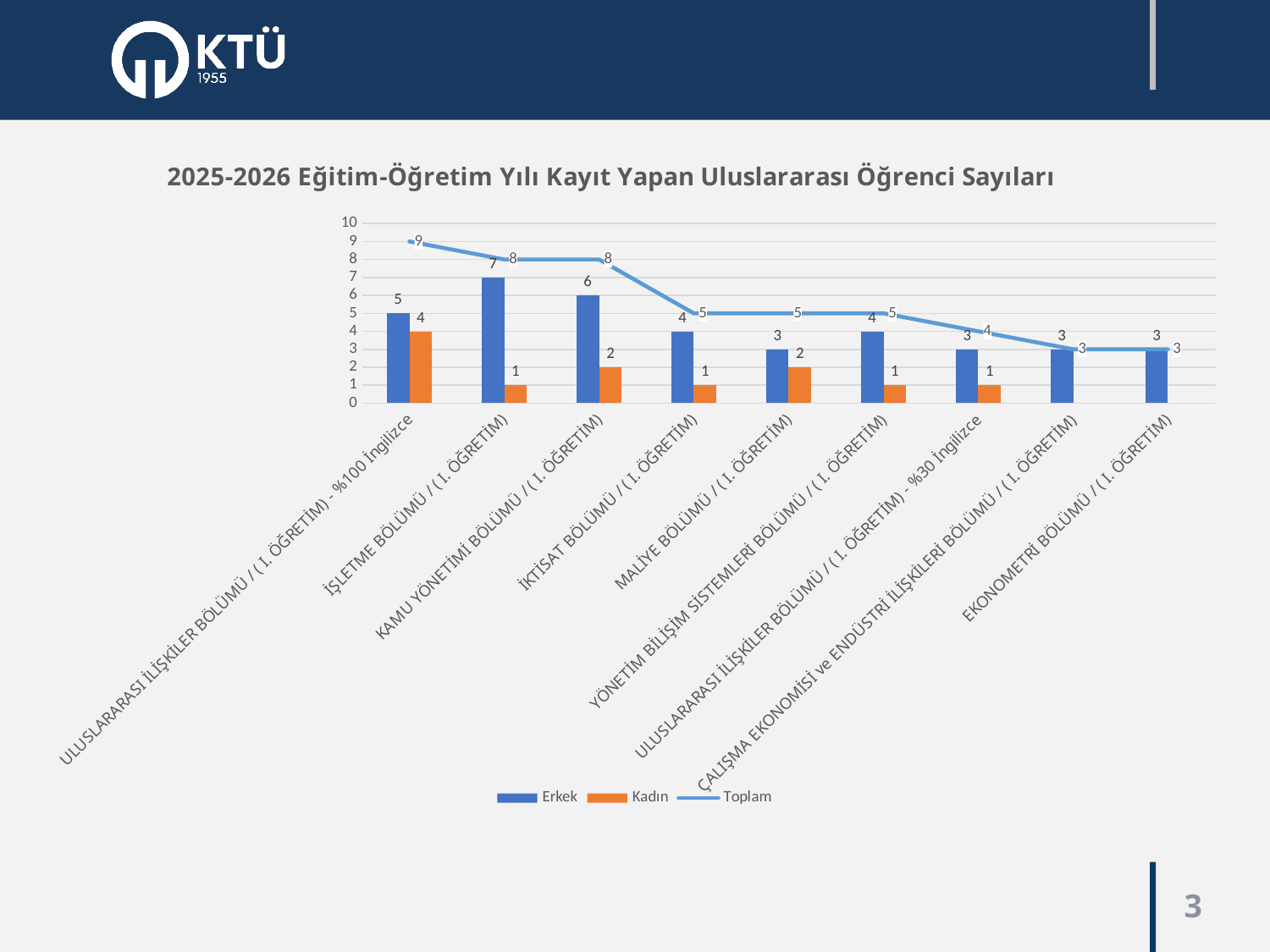
Which category has the highest Erkek value? İŞLETME BÖLÜMÜ / (I. ÖĞRETİM) Which is larger, the Erkek value for KAMU YÖNETİMİ BÖLÜMÜ / (I. ÖĞRETİM) or the Erkek value for MALİYE BÖLÜMÜ / (I. ÖĞRETİM)? KAMU YÖNETİMİ BÖLÜMÜ / (I. ÖĞRETİM) How many series does the legend list? 3 Which category has the highest Kadın value? ULUSLARARASI İLİŞKİLER BÖLÜMÜ / (I. ÖĞRETİM) - %100 İngilizce What is the Kadın value for KAMU YÖNETİMİ BÖLÜMÜ / (I. ÖĞRETİM)? 2 What kind of chart is this? Combined bar and line chart Which category has the highest Toplam value? ULUSLARARASI İLİŞKİLER BÖLÜMÜ / (I. ÖĞRETİM) - %100 İngilizce How many categories are shown on the x axis? 9 What is the Erkek value for İŞLETME BÖLÜMÜ / (I. ÖĞRETİM)? 7 What is the Toplam value for ULUSLARARASI İLİŞKİLER BÖLÜMÜ / (I. ÖĞRETİM) - %100 İngilizce? 9 Does the Toplam line rise or fall from left to right across the categories? Fall What is the difference between the Erkek and Kadın values for İŞLETME BÖLÜMÜ / (I. ÖĞRETİM)? 6